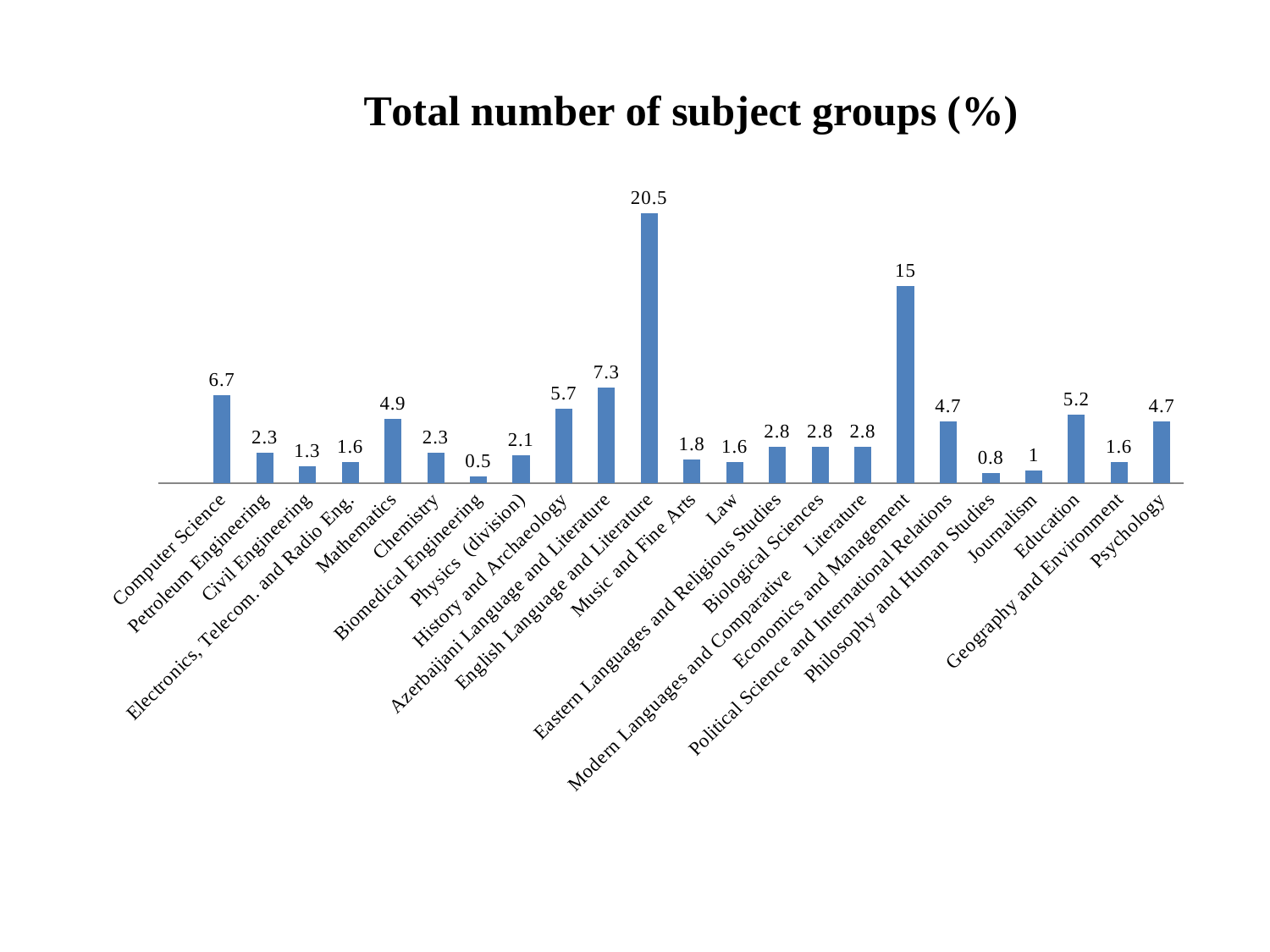
What is the difference between the values for Computer Science and Azerbaijani Language and Literature? 0.6 What is the value for Economics and Management? 15 Which is larger, the value for History and Archaeology or the value for Education? History and Archaeology Which subject group has the lowest value? Biomedical Engineering What is the value for Biomedical Engineering? 0.5 What is the value for Mathematics? 4.9 What is the value for English Language and Literature? 20.5 How many subject groups are shown in the chart? 23 What is the difference between the values for English Language and Literature and Economics and Management? 5.5 What kind of chart is shown on the slide? Bar chart Which subject group has the highest value? English Language and Literature What is the title of the chart? Total number of subject groups (%)